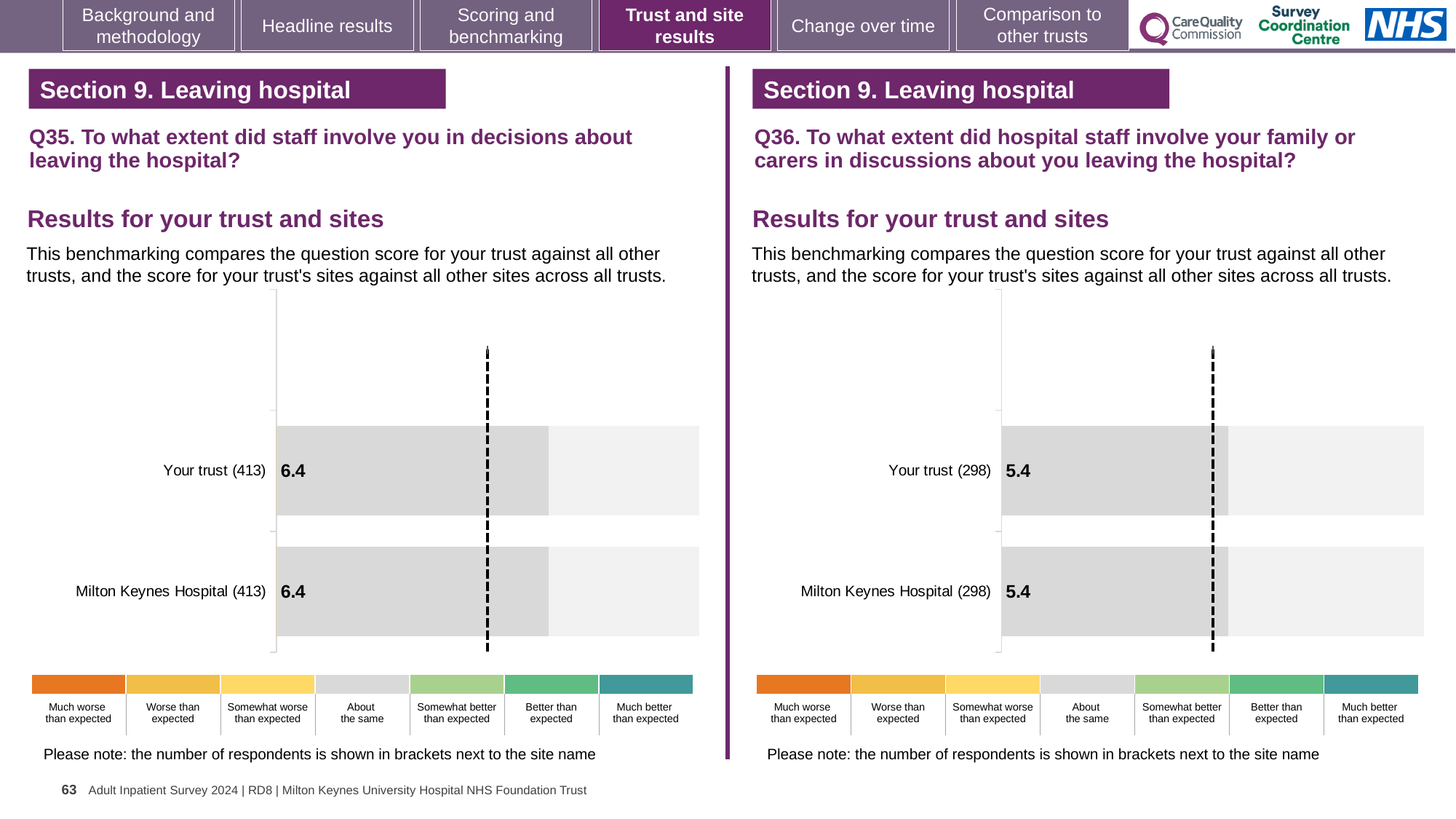
In the Q35 chart on the left, what is the difference between the score for Your trust and the score for Milton Keynes Hospital? 0 In the Q35 chart on the left, what is the score for Your trust? 6.4 In the Q36 chart on the right, how many respondents are shown in brackets next to Milton Keynes Hospital? 298 Is the score for Your trust in the Q36 chart on the right larger or smaller than the score for Your trust in the Q35 chart on the left? Smaller How many bars are plotted in the Q36 chart on the right? 2 In the Q36 chart on the right, what is the difference between the score for Your trust and the score for Milton Keynes Hospital? 0 In the Q36 chart on the right, what is the score for Your trust? 5.4 How many bars are plotted in the Q35 chart on the left? 2 In the Q35 chart on the left, how many respondents are shown in brackets next to Your trust? 413 In the Q36 chart on the right, what is the score for Milton Keynes Hospital? 5.4 What kind of chart is used for the Q35 results on the left? Bar chart In the Q35 chart on the left, what is the score for Milton Keynes Hospital? 6.4